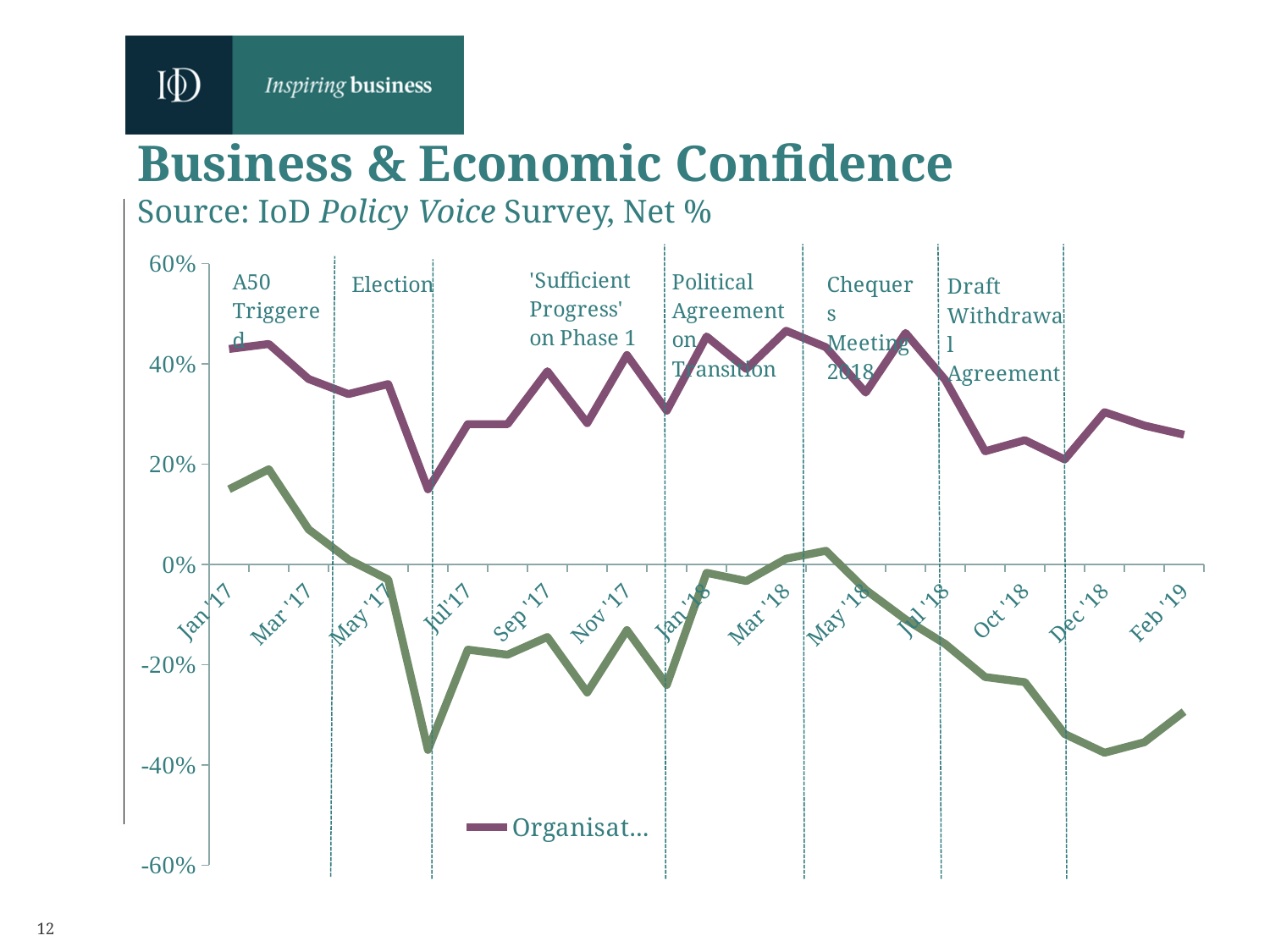
Is the value of the green line at Feb '19 greater or less than -20%? less At Jan '17, which line has the higher value, the purple line or the green line? the purple line How many vertical dashed event lines are marked on the chart? 6 How many month labels are shown along the x axis of the chart? 13 What kind of chart is shown on the slide? line chart Is the value of the purple line at Feb '19 greater or less than 20%? greater Is the value of the green line at Jan '17 greater or less than 20%? less What is the title of the chart on the slide? Business & Economic Confidence Does the green line rise or fall between Jan '17 and May '17? fall